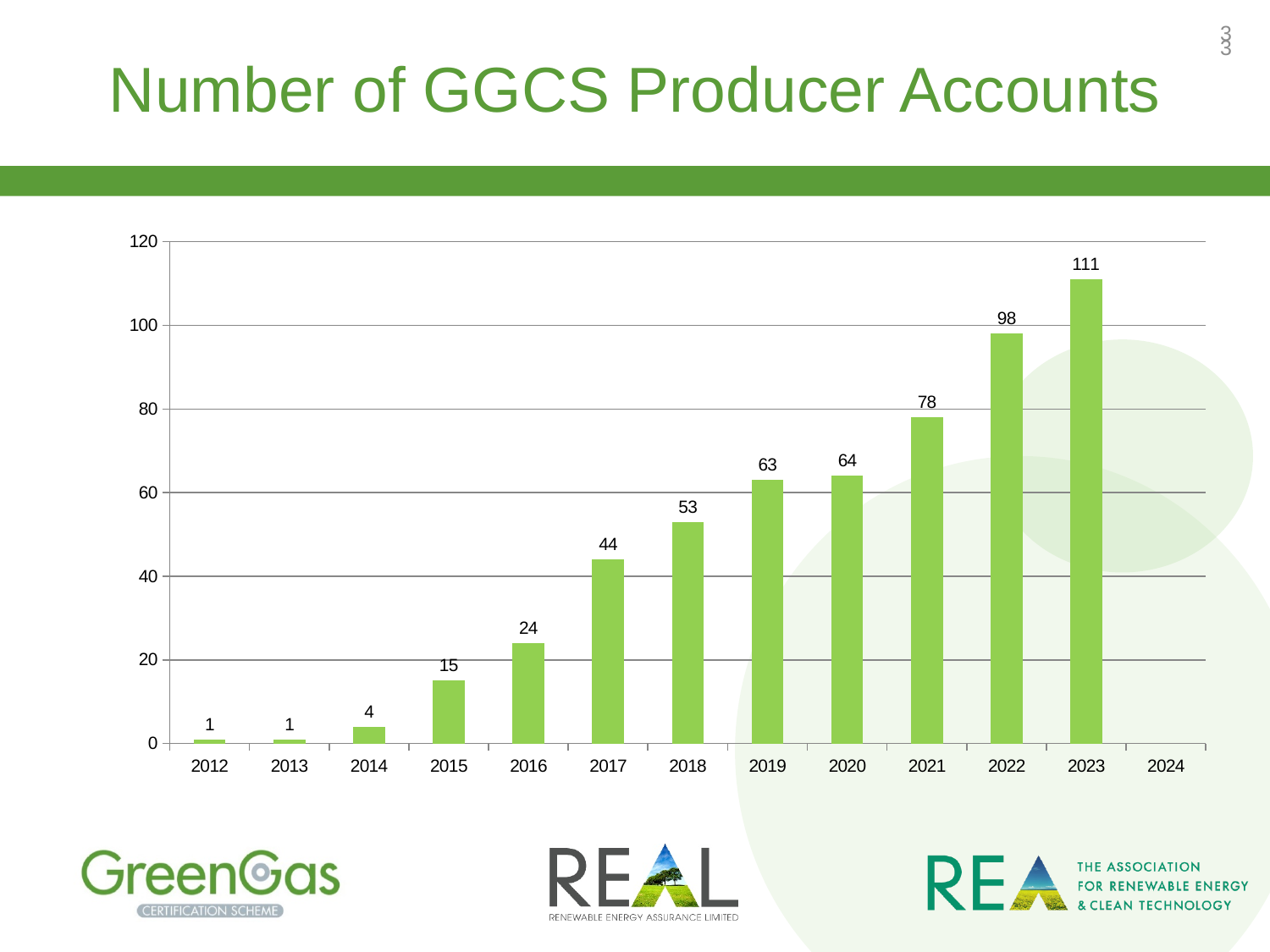
What is the difference between the values for 2021 and 2020? 14 What is the title of the chart? Number of GGCS Producer Accounts What is the lowest value shown on the chart? 1 What is the difference between the values for 2023 and 2022? 13 What is the value shown for 2022? 98 How many GGCS producer accounts were there in 2018? 53 Is the value for 2021 greater or less than 60? greater What is the value shown for 2015? 15 Which year has the larger value, 2017 or 2018? 2018 What type of chart is shown on the slide? bar chart Which year has the highest number of producer accounts? 2023 Do the values generally rise or fall from 2012 to 2023? rise